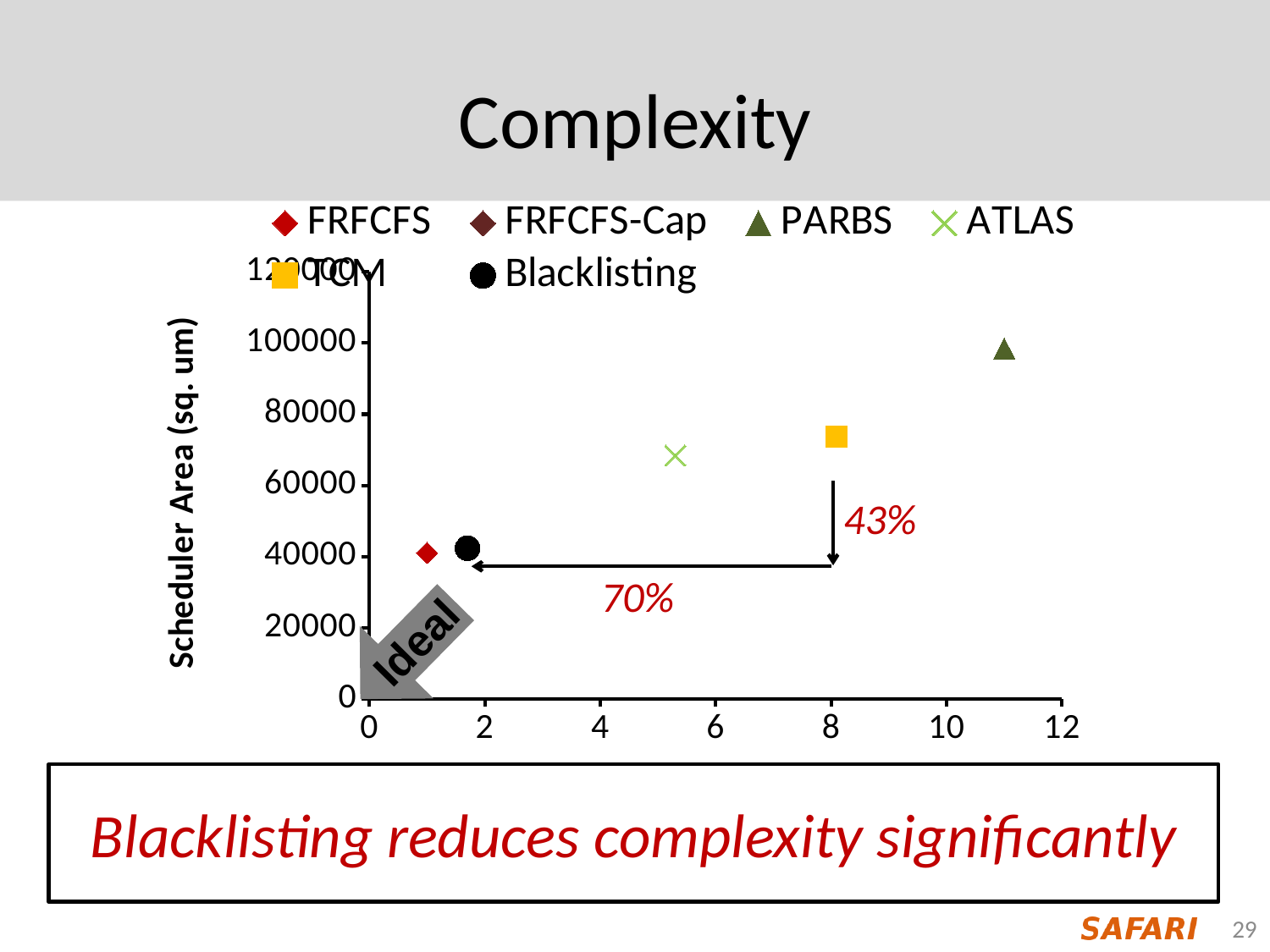
Which has a larger Scheduler Area, PARBS or TCM? PARBS Is the x-axis value for ATLAS greater or less than 4? greater How many series does the legend list? 6 Is the x-axis value for PARBS greater or less than 10? greater What is the label of the y-axis? Scheduler Area (sq. um) Is the Scheduler Area for Blacklisting greater or less than 60000? less What percentage is written next to the horizontal arrow from TCM to Blacklisting? 70% What kind of chart is shown on the slide? scatter chart Which scheduler has the highest Scheduler Area? PARBS